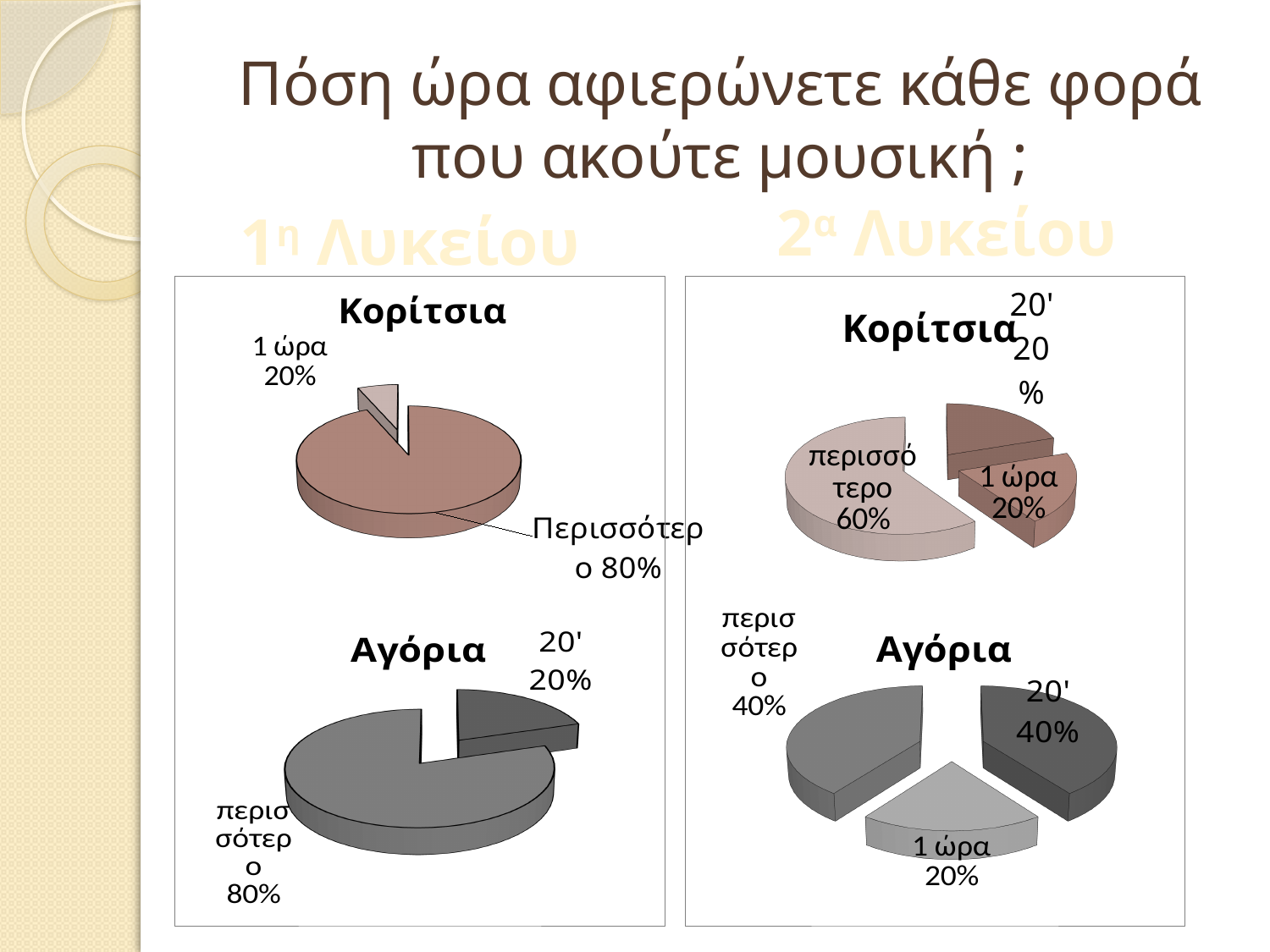
In the 1η Λυκείου Κορίτσια pie chart, what is the difference between the Περισσότερο share and the 1 ώρα share? 60% In the 1η Λυκείου Αγόρια pie chart, what share is labelled 20'? 20% How many pie charts are shown on the slide in total? 4 In the 2α Λυκείου Κορίτσια pie chart, what share is labelled περισσότερο? 60% In the 1η Λυκείου Κορίτσια pie chart, what share is labelled 1 ώρα? 20% What kind of chart is used for the Αγόρια data in the 2α Λυκείου panel? Pie chart In the 2α Λυκείου Αγόρια pie chart, what is the difference between the 20' share and the 1 ώρα share? 20% In the 2α Λυκείου Αγόρια pie chart, which slice is the smallest? 1 ώρα In the 2α Λυκείου Κορίτσια pie chart, how many slices are there? 3 In the 1η Λυκείου Κορίτσια pie chart, what share is labelled Περισσότερο? 80% In the 2α Λυκείου Αγόρια pie chart, what share is labelled 1 ώρα? 20% In the 1η Λυκείου Αγόρια pie chart, which slice is the largest? περισσότερο